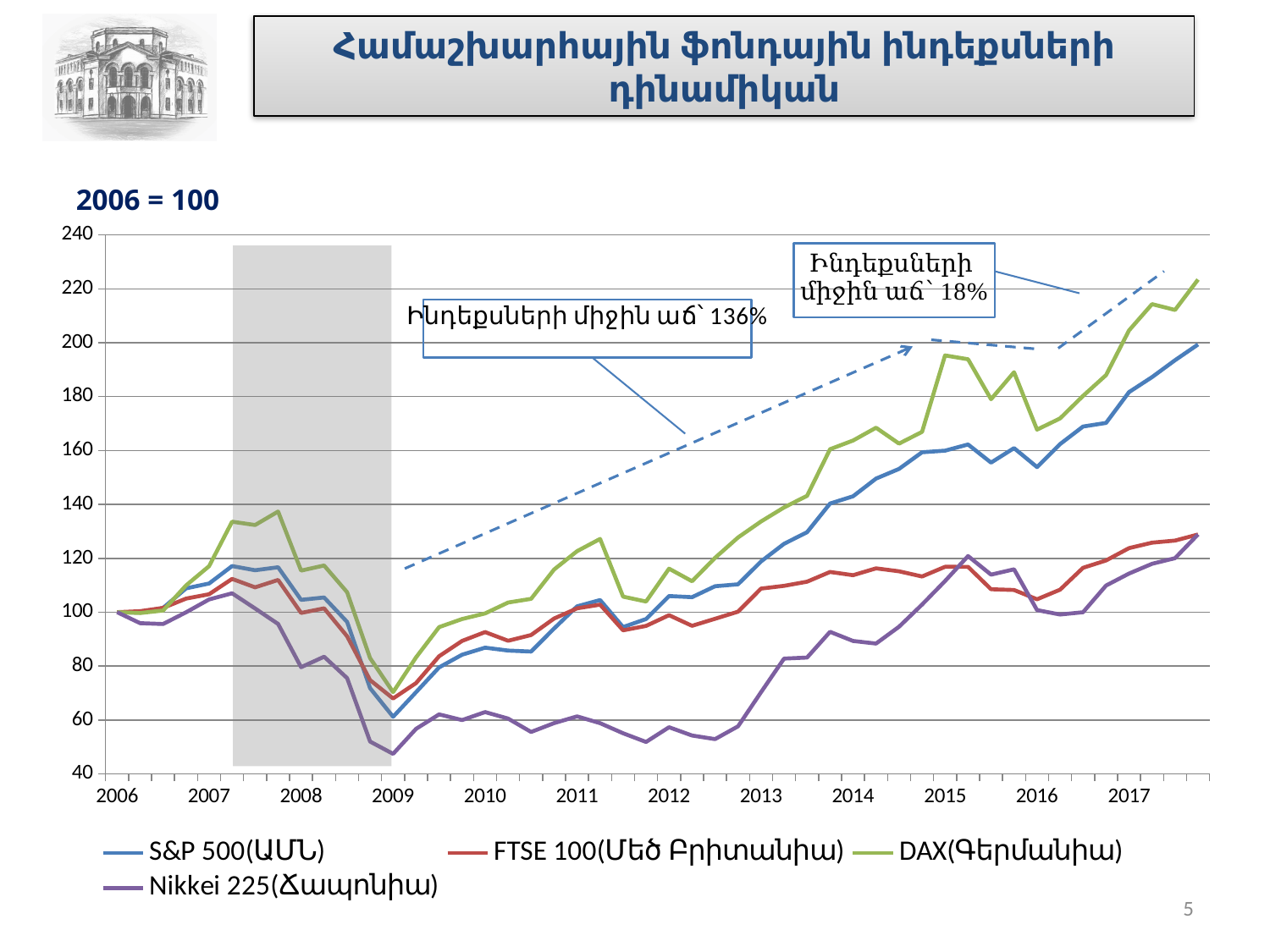
How many series does the legend list? 4 Is the value of Nikkei 225(Ճապոնիա) at the start of 2009 greater or less than 60? less Is the value of S&P 500(ԱՄՆ) at the end of 2017 greater or less than 180? greater Which is larger in 2014: the value of DAX(Գերմանիա) or the value of FTSE 100(Մեծ Բրիտանիա)? DAX(Գերմանիա) Which series has the highest value at the end of 2017? DAX(Գերմանիա) Is the value of DAX(Գերմանիա) at the end of 2017 greater or less than 200? greater What kind of chart is shown on the slide? line chart What average index growth is stated in the annotation for the period from 2009 to 2015? 136% What base value is the index set to in 2006, according to the label above the chart? 2006 = 100 Does the S&P 500(ԱՄՆ) series rise or fall between 2009 and 2017? rise Which is larger in 2012: the value of S&P 500(ԱՄՆ) or the value of Nikkei 225(Ճապոնիա)? S&P 500(ԱՄՆ) Which series has the lowest value in 2010? Nikkei 225(Ճապոնիա)